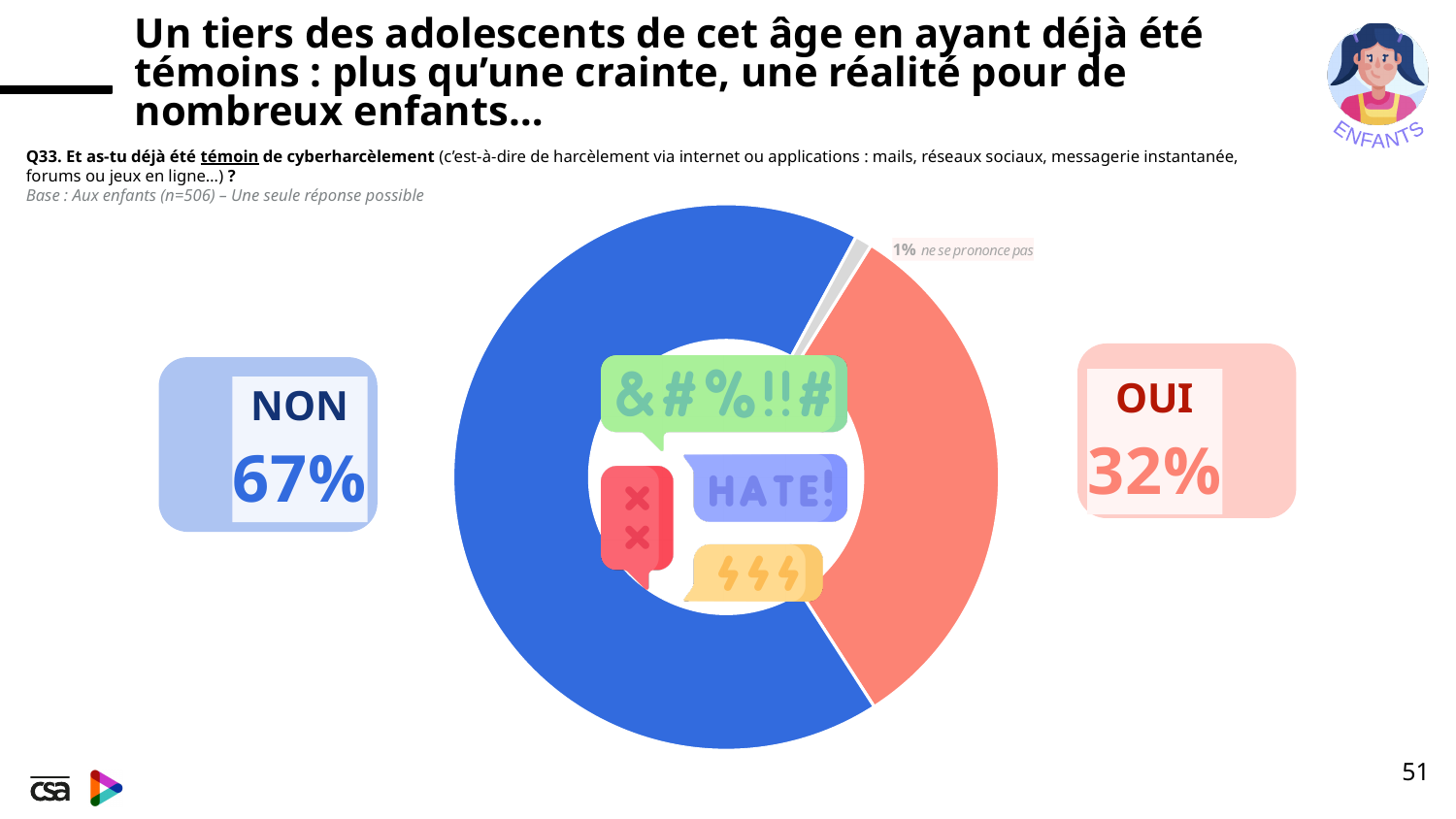
What colour is the slice representing NON? Blue Which response has the smallest share of the pie? ne se prononce pas What is the difference in percentage points between NON and OUI? 35 How many slices does the pie chart have? 3 What percentage of children answered NON? 67% What is the sample size (n) stated for the base of this chart? 506 What kind of chart is shown on the slide? Pie chart (doughnut) Which response has the largest share of the pie? NON Which is larger, the share for OUI or the share for NON? NON What percentage of children answered OUI? 32% What colour is the slice representing OUI? Red (salmon) What percentage of children did not give an answer (ne se prononce pas)? 1%